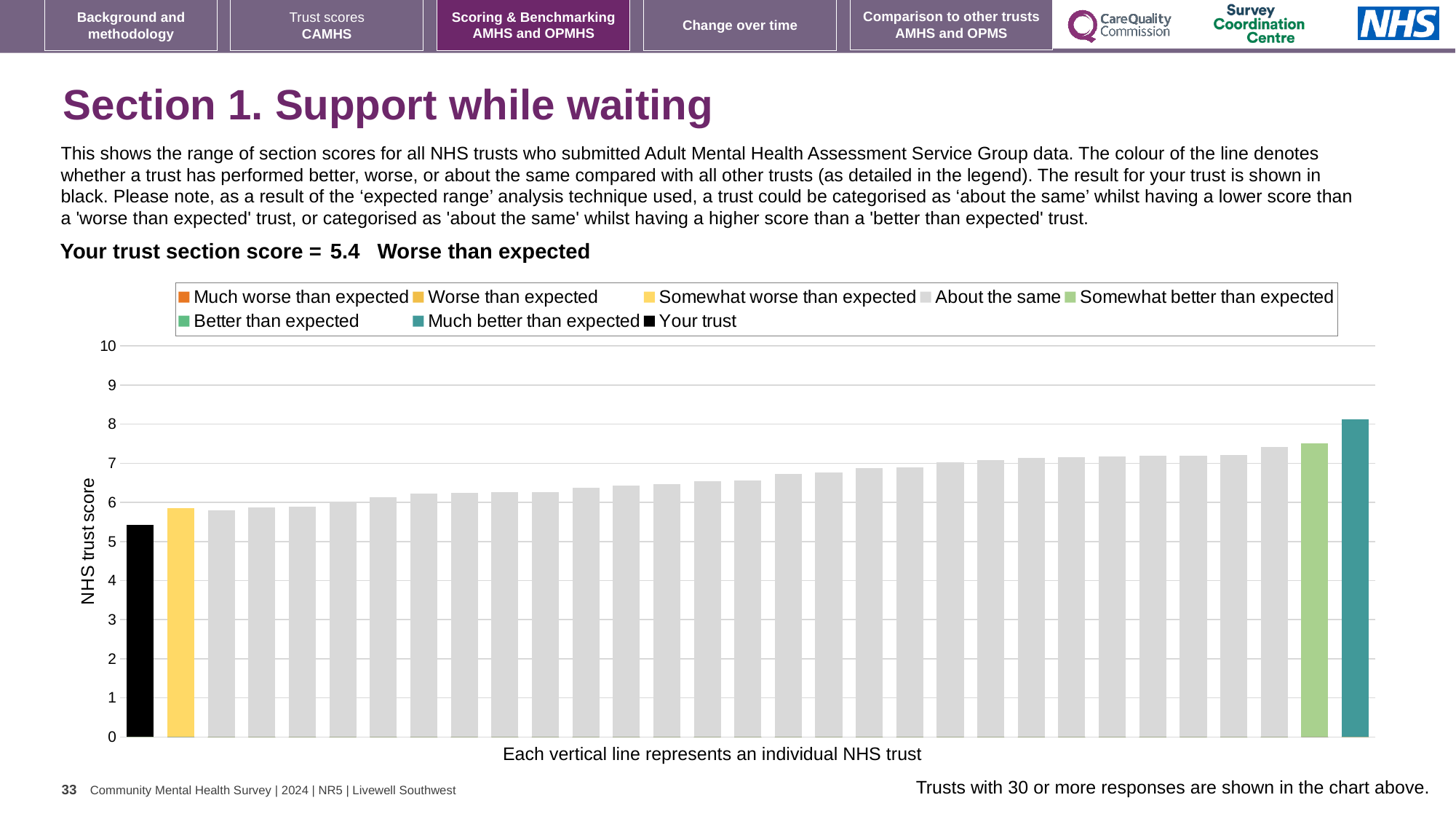
Do the bar values rise or fall from left to right across the chart? rise What is the label on the vertical axis of the chart? NHS trust score Is the value of the 'Much better than expected' bar greater or less than 7? greater What is the section score for 'Your trust' shown on the slide? 5.4 Is the value of the 'Your trust' bar greater or less than 6? less How many entries does the chart legend list? 8 What kind of chart is shown on the slide? bar chart Which legend category does the lowest bar in the chart belong to? Your trust Which is larger: the 'Your trust' bar or the 'Much better than expected' bar? Much better than expected Is the value of the 'Somewhat better than expected' bar greater or less than 7? greater According to the slide, how is your trust's section score categorised? Worse than expected Which legend category does the highest bar in the chart belong to? Much better than expected